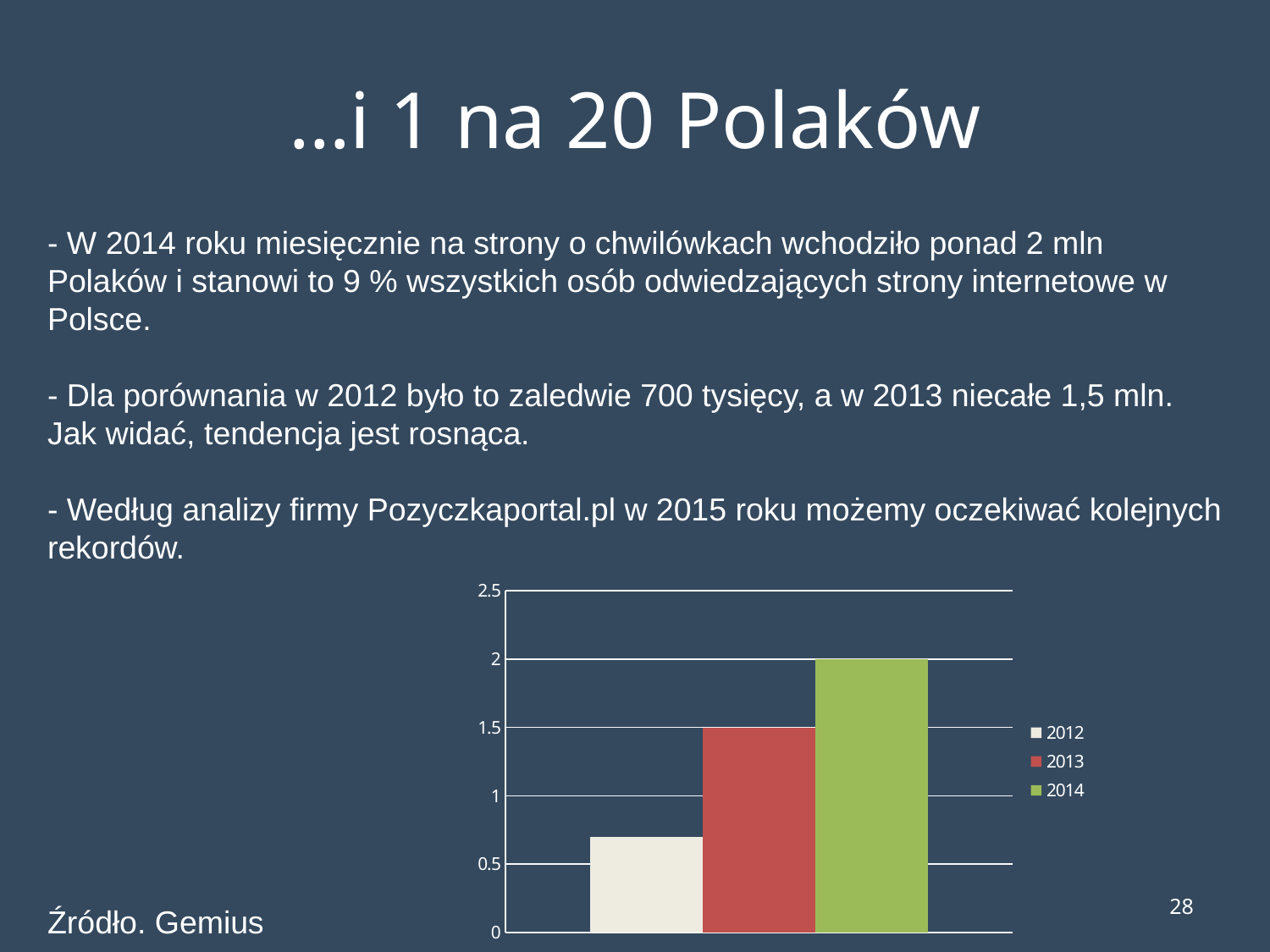
Which is larger, the 2013 bar or the 2012 bar? 2013 Is the value for 2012 greater or less than 1? less Do the bar values rise or fall from 2012 to 2014? rise Which series has the shortest bar in the chart? 2012 What colour is the 2013 bar in the chart? red What kind of chart is shown on the slide? bar chart What is the difference between the 2014 bar and the 2013 bar? 0.5 How many series does the chart legend list? 3 What is the value of the 2013 bar in the chart? 1.5 Is the value for 2012 greater or less than 0.5? greater Which series has the tallest bar in the chart? 2014 What is the value of the 2014 bar in the chart? 2